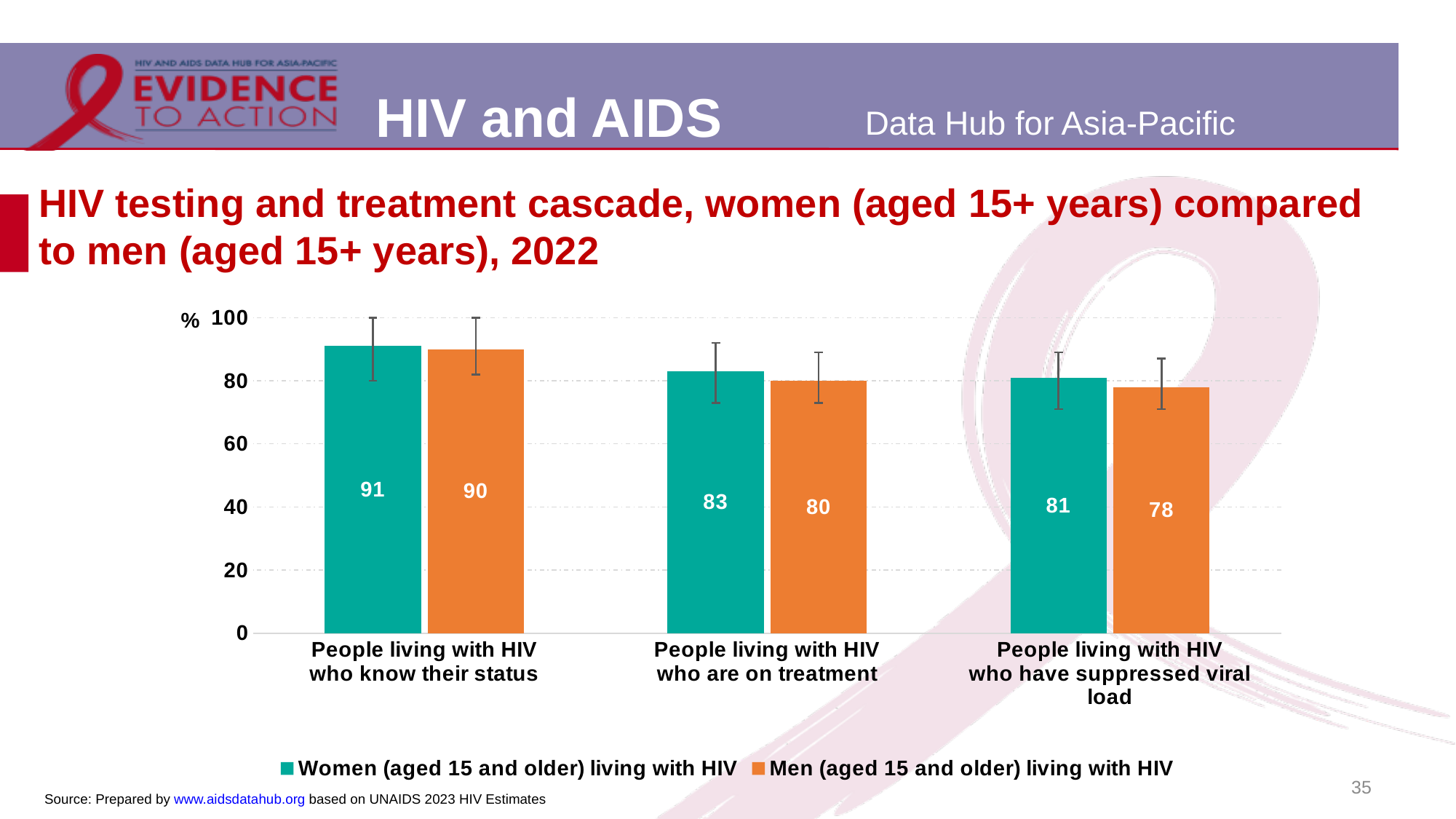
What is the value for men (aged 15 and older) living with HIV who have suppressed viral load? 78 Which is larger: the women's value or the men's value for people living with HIV who have suppressed viral load? Women (aged 15 and older) living with HIV What is the value for men (aged 15 and older) living with HIV who are on treatment? 80 What is the difference between the women's values for people who know their status and people who have suppressed viral load? 10 What kind of chart is shown on the slide? Bar chart Which category has the lowest value for men (aged 15 and older) living with HIV? People living with HIV who have suppressed viral load How many categories are shown on the x axis? 3 How many series does the legend list? 2 What is the value for women (aged 15 and older) living with HIV who know their status? 91 Do the values for men (aged 15 and older) living with HIV rise or fall across the categories from left to right? Fall Which category has the highest value for women (aged 15 and older) living with HIV? People living with HIV who know their status What is the difference between the women and men values for people living with HIV who are on treatment? 3